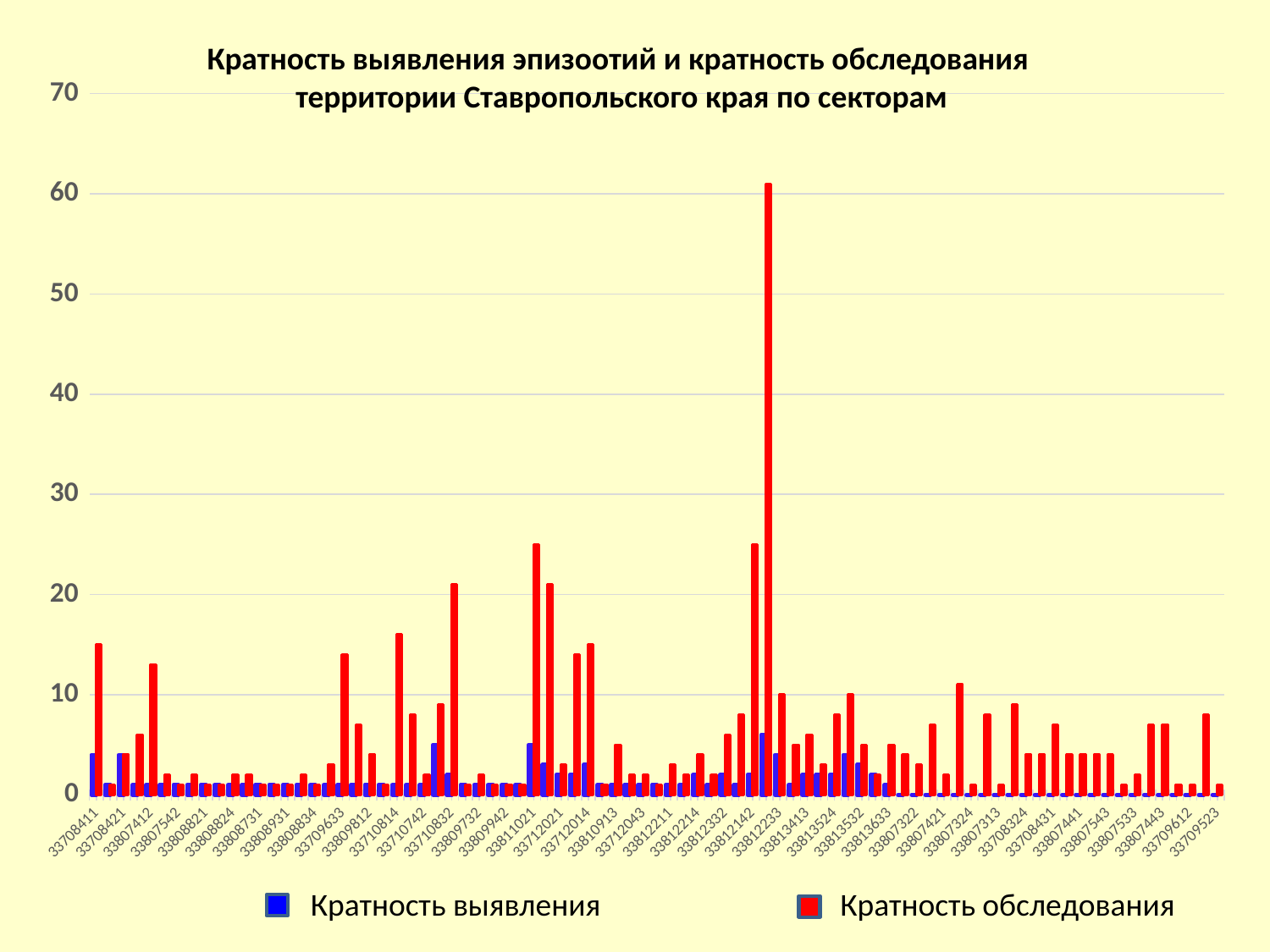
Is the tallest bar of the Кратность выявления series greater or less than 10? less What kind of chart is shown on the slide? bar chart What are the two series named in the legend? Кратность выявления and Кратность обследования What is the highest value shown on the vertical axis? 70 How many series does the legend list? 2 Which colour represents the series Кратность обследования? red Which series reaches the higher maximum value, Кратность выявления or Кратность обследования? Кратность обследования Is the tallest bar of the Кратность обследования series greater or less than 50? greater Is the tallest bar of the Кратность обследования series greater or less than 60? greater